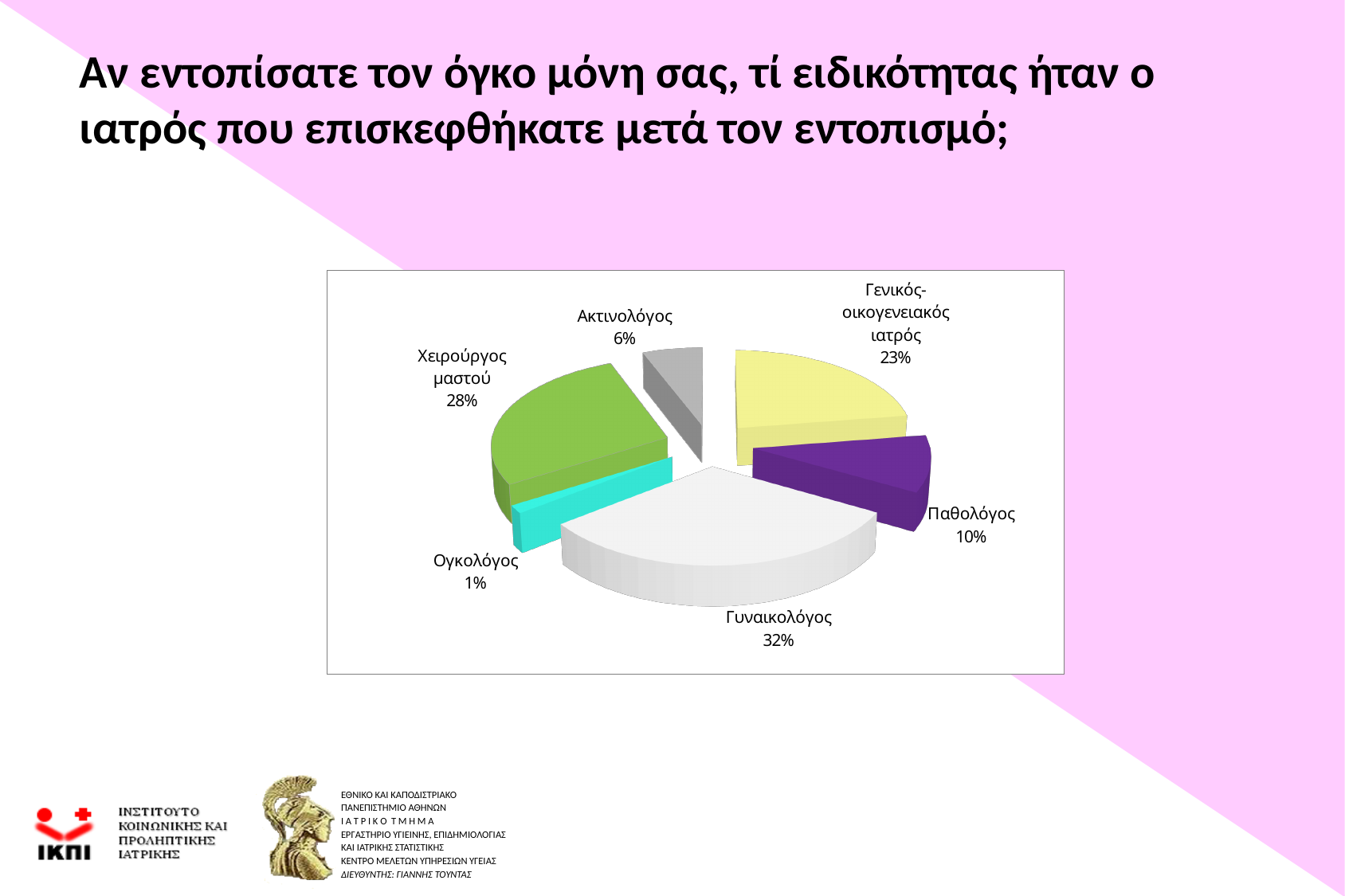
What is the difference between the shares of Παθολόγος and Ακτινολόγος? 4% What share of the pie does Γυναικολόγος have? 32% How many categories are shown in the pie chart? 6 What is the difference between the shares of Γυναικολόγος and Χειρούργος μαστού? 4% Which category has the smallest slice of the pie? Ογκολόγος What kind of chart is shown on the slide? Pie chart What is the value for Παθολόγος? 10% What is the value for Ακτινολόγος? 6% What percentage is shown for Γενικός-οικογενειακός ιατρός? 23% What is the value shown for Χειρούργος μαστού? 28% Which is larger, the share for Γενικός-οικογενειακός ιατρός or for Παθολόγος? Γενικός-οικογενειακός ιατρός Which category has the largest slice of the pie? Γυναικολόγος